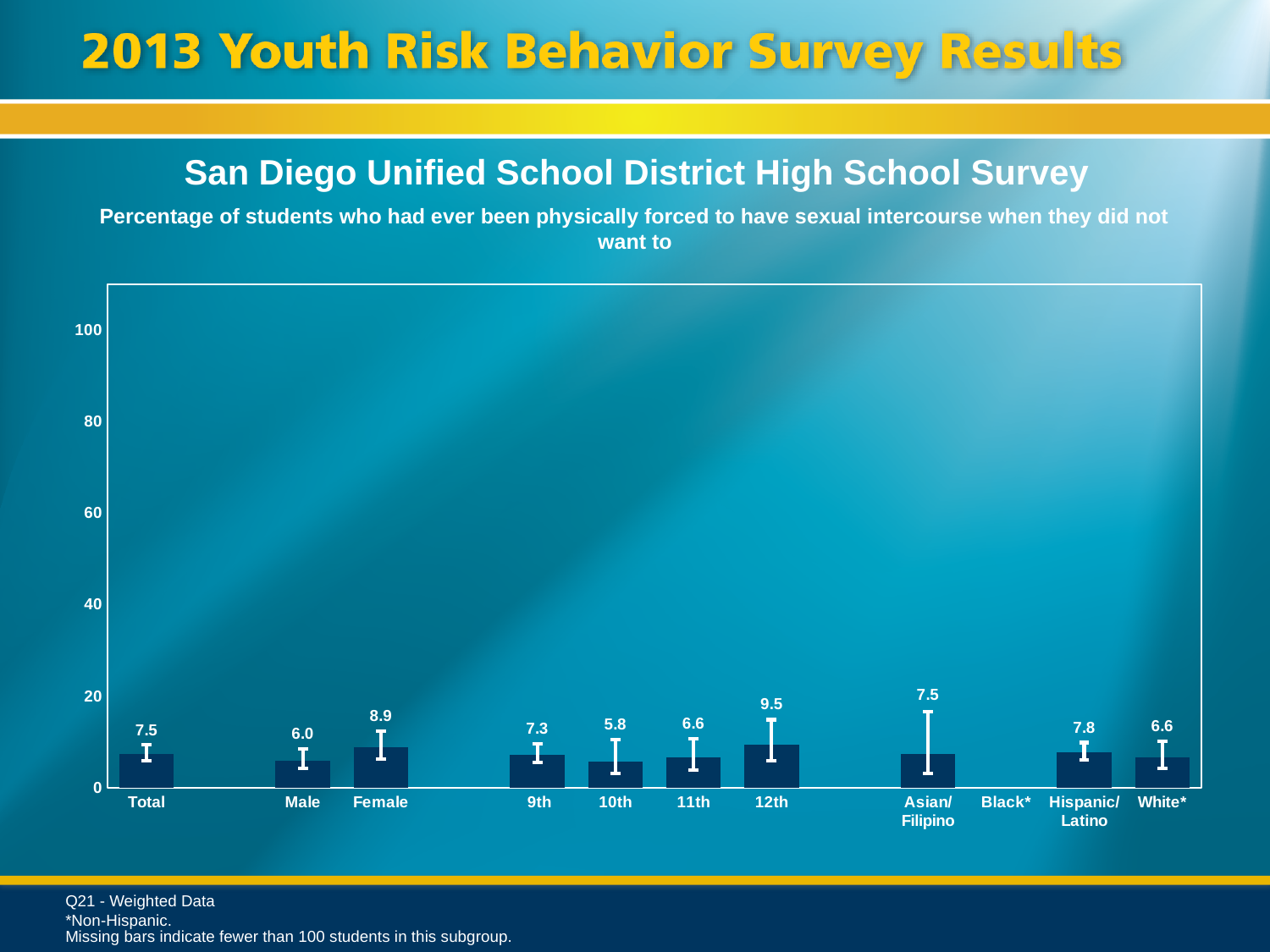
Is the value for 12th grade greater or less than 20? less What is the value for 12th grade? 9.5 What is the difference between the Female and Male values? 2.9 What is the value for Hispanic/Latino? 7.8 Which category has no bar shown? Black* What kind of chart is shown on the slide? bar chart Which grade level has the lowest value? 10th What is the value for Female? 8.9 Which grade level has the highest value? 12th What is the value for Male? 6.0 Which is larger, the value for 9th grade or the value for 11th grade? 9th What is the value for Total? 7.5